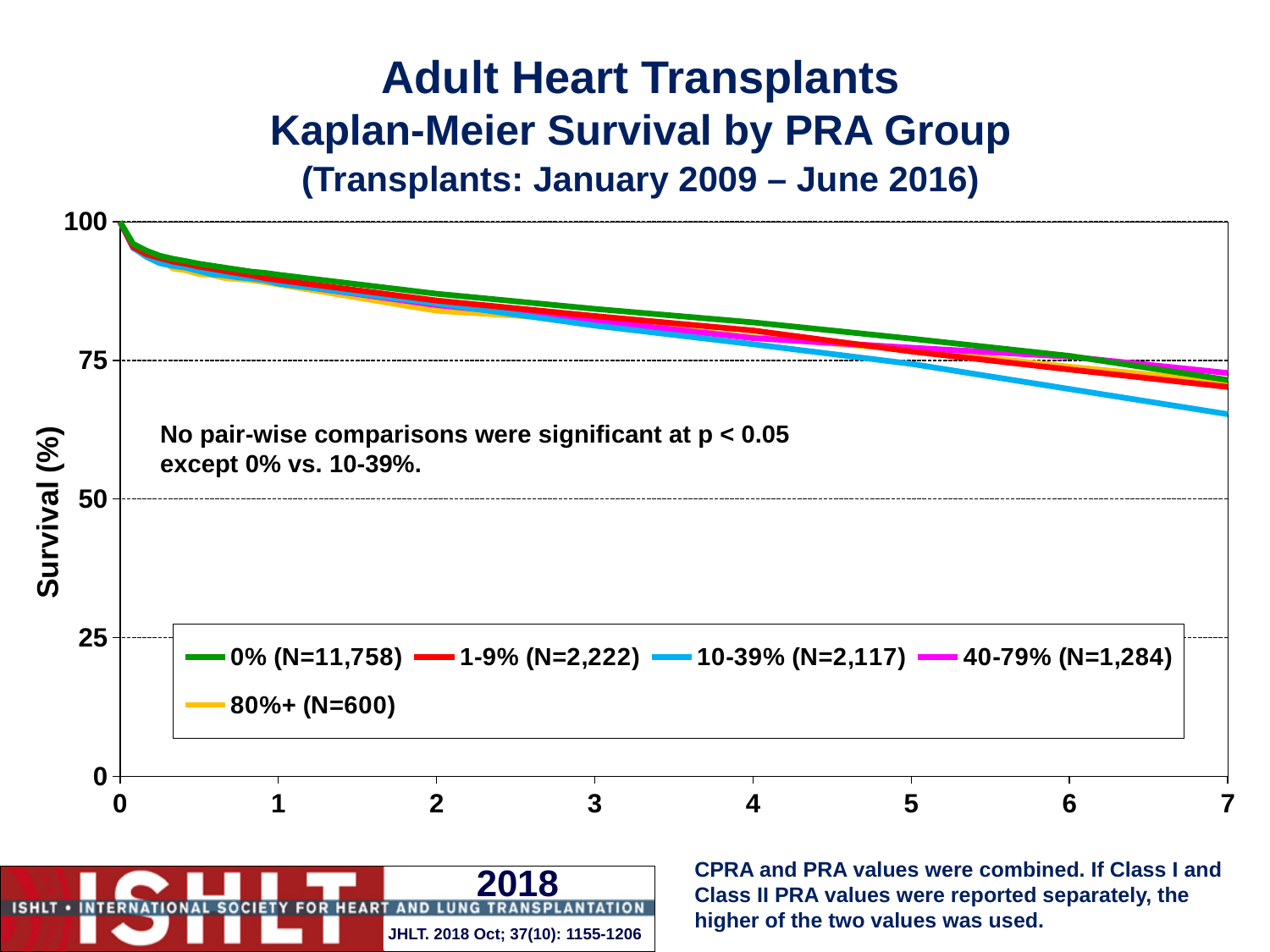
According to the legend, what is the N for the 80%+ PRA group? 600 Is the survival for the 0% group at year 7 greater or less than 50? greater Is the survival for the 0% group at year 1 greater or less than 75? greater What is the label of the y axis? Survival (%) How many PRA groups (series) does the legend list? 5 At year 7, which group has higher survival: 1-9% or 10-39%? 1-9% At year 6, which group has higher survival: 0% or 10-39%? 0% Do the survival curves rise or fall as time (years) increases along the x axis? fall Is the survival for the 10-39% group at year 6 greater or less than 75? less What kind of chart is shown on the slide? line chart Which PRA group has the lowest survival at year 7? 10-39% (N=2,117)